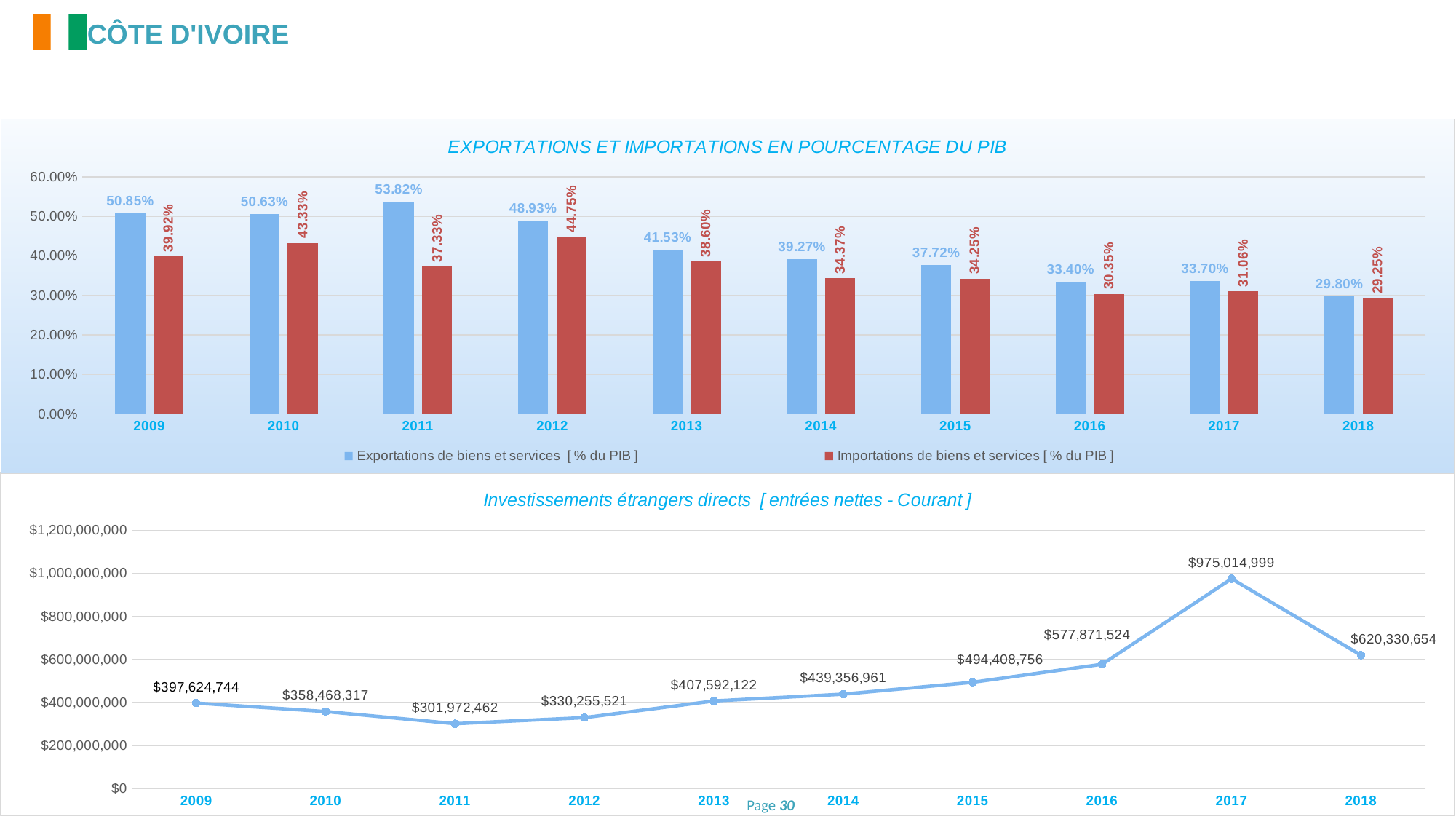
In the chart titled 'EXPORTATIONS ET IMPORTATIONS EN POURCENTAGE DU PIB', which year has the lowest value for Importations de biens et services? 2018 In the chart titled 'EXPORTATIONS ET IMPORTATIONS EN POURCENTAGE DU PIB', what is the value of Exportations de biens et services for 2011? 53.82% What kind of chart is the chart titled 'Investissements étrangers directs [ entrées nettes - Courant ]'? Line chart In the chart titled 'Investissements étrangers directs [ entrées nettes - Courant ]', which year has the lowest value? 2011 In the chart titled 'Investissements étrangers directs [ entrées nettes - Courant ]', is the value for 2016 larger or smaller than the value for 2018? Smaller What kind of chart is the chart titled 'EXPORTATIONS ET IMPORTATIONS EN POURCENTAGE DU PIB'? Bar chart In the chart titled 'Investissements étrangers directs [ entrées nettes - Courant ]', what is the value for 2017? $975,014,999 In the chart titled 'EXPORTATIONS ET IMPORTATIONS EN POURCENTAGE DU PIB', how many series does the legend list? 2 In the chart titled 'EXPORTATIONS ET IMPORTATIONS EN POURCENTAGE DU PIB', what is the difference between Exportations and Importations in 2009? 10.93% In the chart titled 'EXPORTATIONS ET IMPORTATIONS EN POURCENTAGE DU PIB', which year has the highest value for Exportations de biens et services? 2011 In the chart titled 'Investissements étrangers directs [ entrées nettes - Courant ]', how many years are plotted? 10 In the chart titled 'EXPORTATIONS ET IMPORTATIONS EN POURCENTAGE DU PIB', what is the value of Importations de biens et services for 2012? 44.75%